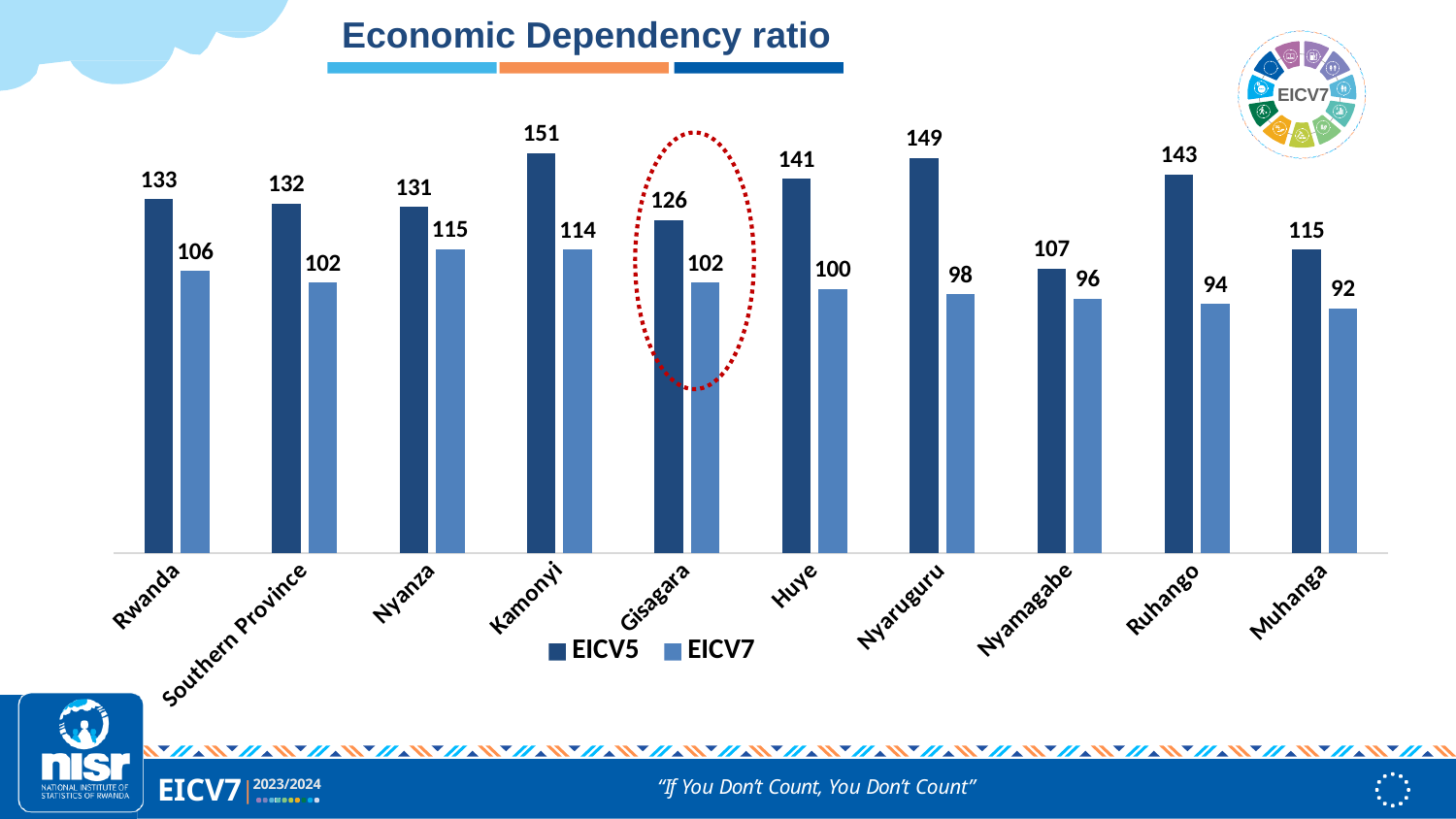
How many categories are shown on the x axis? 10 Which category has the highest EICV5 value? Kamonyi What is the EICV7 economic dependency ratio for Gisagara? 102 What is the difference between the EICV5 and EICV7 values for Ruhango? 49 How many series does the legend list? 2 Which category is highlighted with a red dotted circle? Gisagara What is the title of the chart? Economic Dependency ratio Which is larger, the EICV5 value for Nyaruguru or the EICV5 value for Huye? Nyaruguru What is the EICV5 economic dependency ratio for Kamonyi? 151 What kind of chart is shown on the slide? Bar chart Which category has the lowest EICV7 value? Muhanga What is the EICV7 value for Rwanda? 106